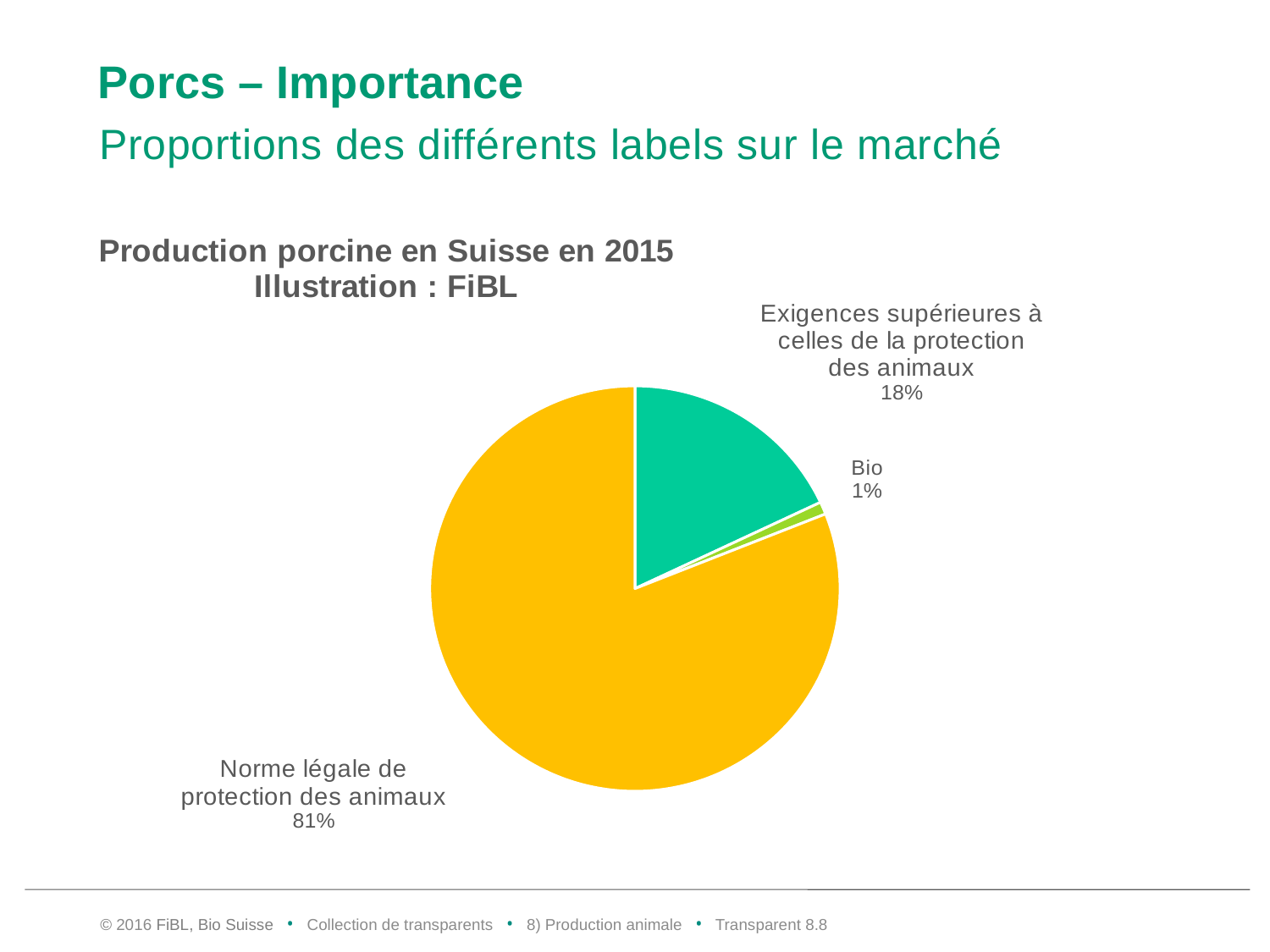
What colour is the 'Norme légale de protection des animaux' slice? yellow What kind of chart is shown on the slide? pie chart Which is larger: the 'Bio' slice or the 'Exigences supérieures à celles de la protection des animaux' slice? Exigences supérieures à celles de la protection des animaux What is the difference in percentage points between 'Norme légale de protection des animaux' and 'Exigences supérieures à celles de la protection des animaux'? 63 What share of the pie is 'Exigences supérieures à celles de la protection des animaux'? 18% What is the difference in percentage points between 'Exigences supérieures à celles de la protection des animaux' and 'Bio'? 17 What share of Swiss pig production in 2015 is labelled 'Norme légale de protection des animaux'? 81% How many slices does the pie chart have? 3 Which slice of the pie is the smallest? Bio What share of the pie is 'Bio'? 1% Which slice of the pie is the largest? Norme légale de protection des animaux What is the title of the chart? Production porcine en Suisse en 2015 Illustration : FiBL